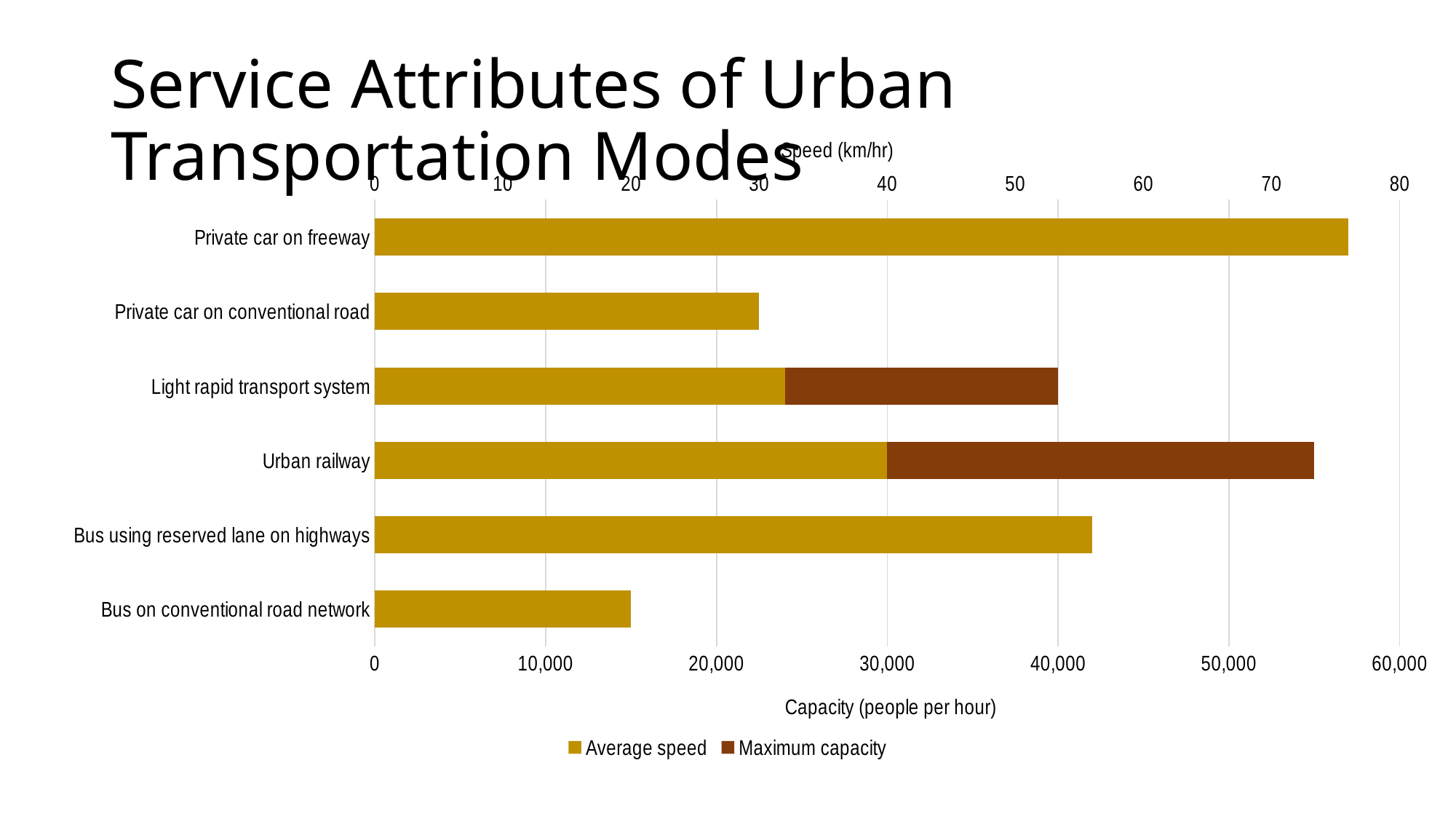
Which transportation mode has the highest average speed? Private car on freeway Is the average speed for Urban railway greater or less than 30 km/hr? greater Is the average speed for Bus using reserved lane on highways greater or less than 50 km/hr? greater Which has a higher average speed, Bus using reserved lane on highways or Urban railway? Bus using reserved lane on highways What is the title of the axis at the top of the chart? Speed (km/hr) How many transportation modes are listed on the chart? 6 What is the title of the axis at the bottom of the chart? Capacity (people per hour) How many series does the legend list? 2 What kind of chart is shown on the slide? Bar chart Is the average speed for Bus on conventional road network greater or less than 30 km/hr? less Which transportation mode has the lowest average speed? Bus on conventional road network